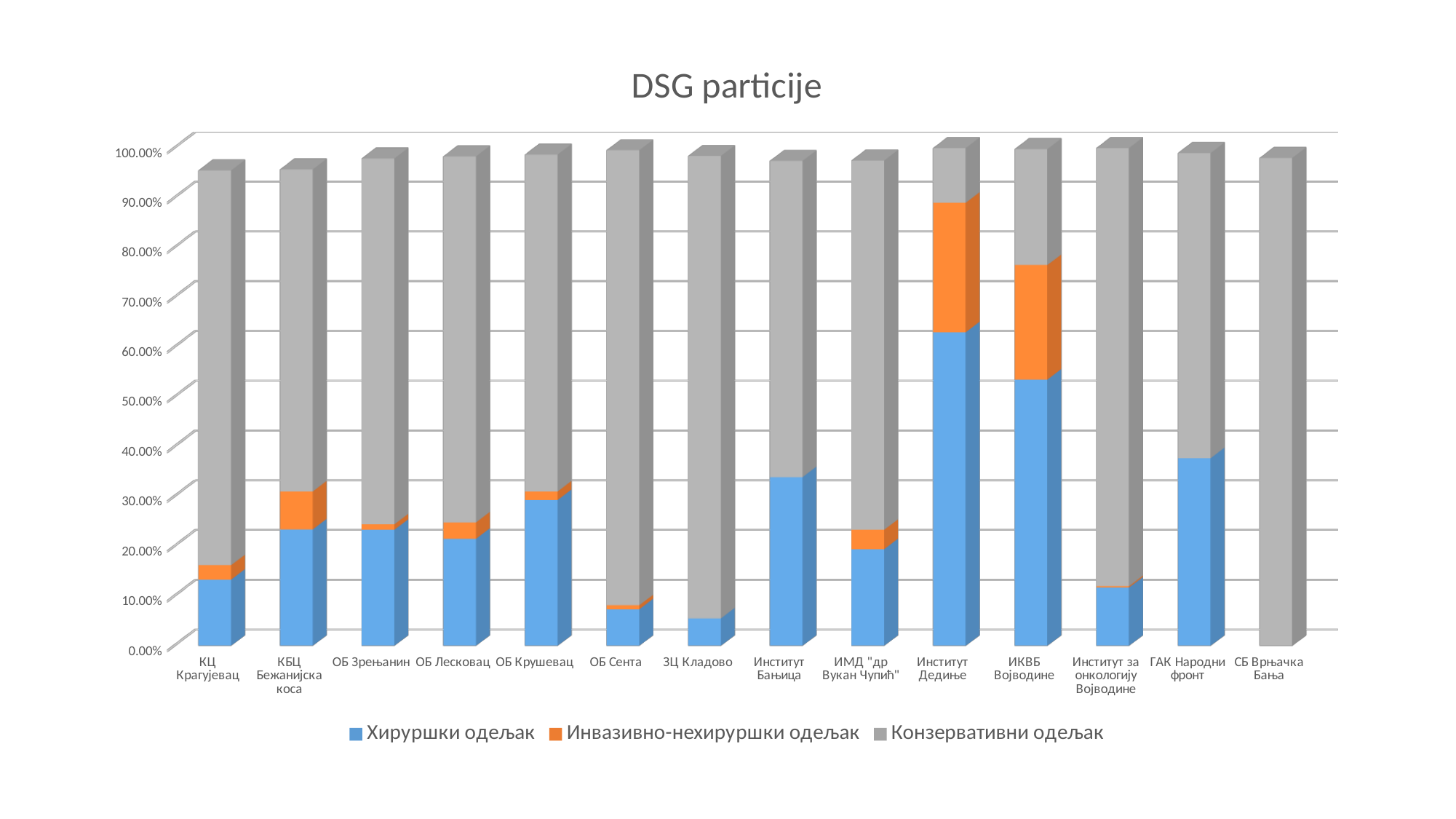
Is the Хируршки одељак share for Институт Дедиње greater or less than 50.00%? greater What is the title of the chart? DSG particije Is the Хируршки одељак share for ГАК Народни фронт greater or less than 30.00%? greater How many series does the legend list? 3 Which has the larger Инвазивно-нехируршки одељак share, Институт Дедиње or КБЦ Бежанијска коса? Институт Дедиње Which series is shown in orange in the legend? Инвазивно-нехируршки одељак Which category has the largest share for Конзервативни одељак? СБ Врњачка Бања What kind of chart is shown on the slide? Stacked bar chart Is the Хируршки одељак share for ЗЦ Кладово greater or less than 10.00%? less How many categories (institutions) are shown on the x axis? 14 Which category has the largest share for Хируршки одељак? Институт Дедиње Which has the larger Хируршки одељак share, Институт Дедиње or ИКВБ Војводине? Институт Дедиње